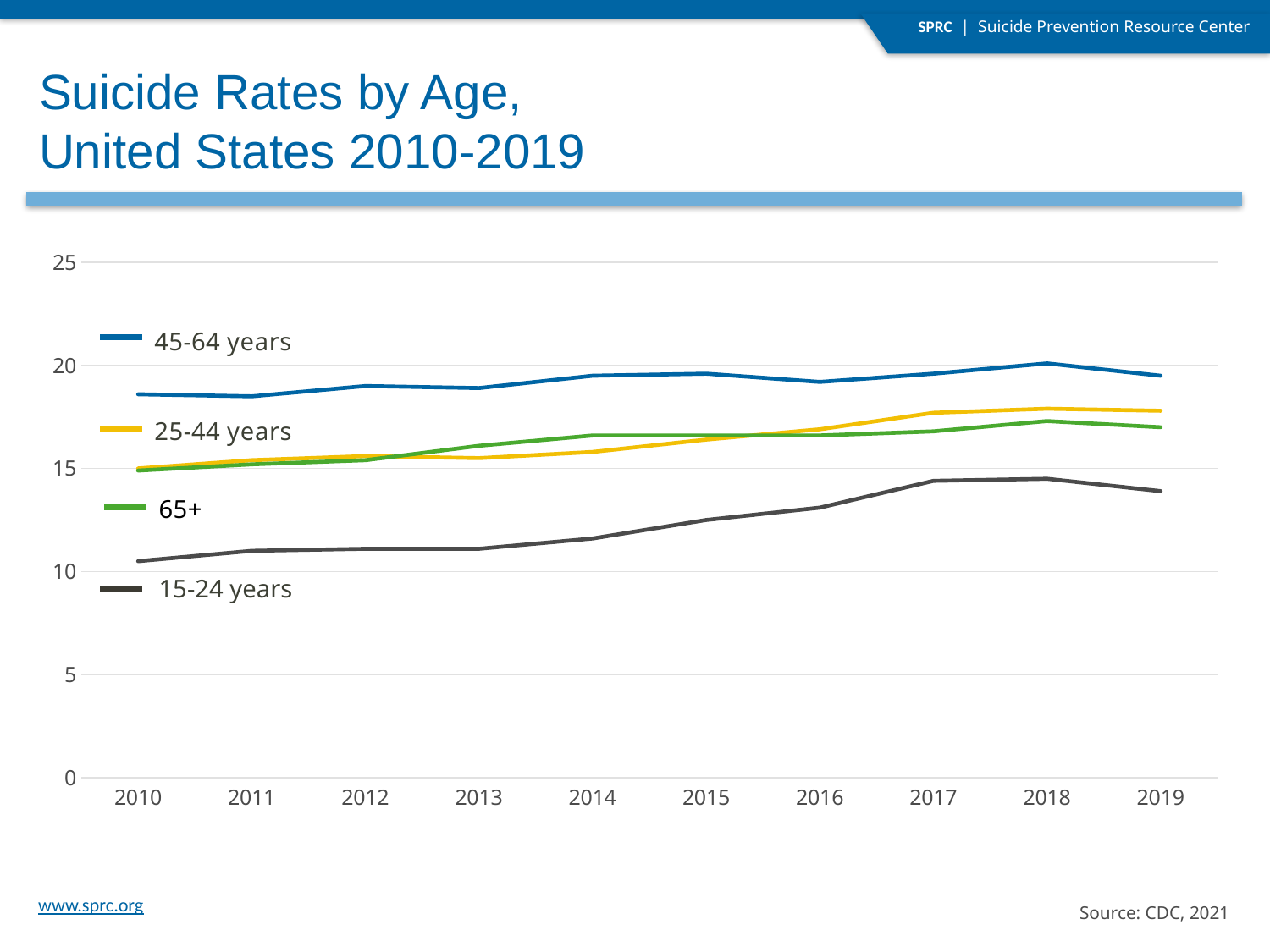
Which age group has the lowest suicide rate in 2010? 15-24 years What kind of chart is shown on the slide? line chart What is the title of the slide's chart? Suicide Rates by Age, United States 2010-2019 Is the value for 65+ in 2014 greater or less than 15? greater Is the value for 25-44 years in 2019 greater or less than 15? greater How many series (age groups) does the chart's legend list? 4 Is the value for 45-64 years in 2010 greater or less than 20? less Does the suicide rate for 15-24 years rise or fall from 2010 to 2018? rise How many years are plotted along the x axis? 10 Which age group has the highest suicide rate in 2019? 45-64 years In 2015, which is larger: the rate for 45-64 years or the rate for 15-24 years? 45-64 years